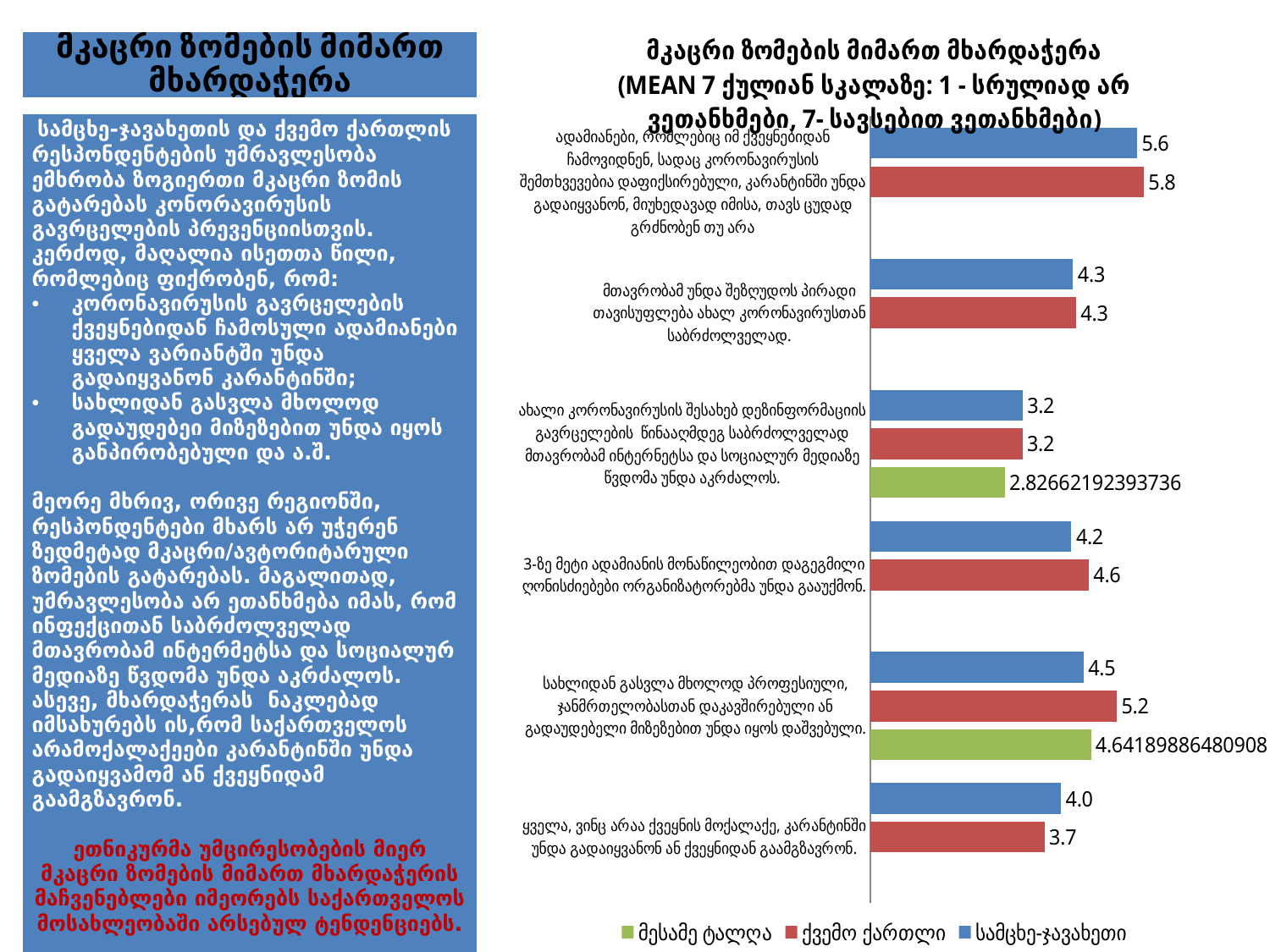
What is the difference between ქვემო ქართლი and სამცხე-ჯავახეთი on the statement about leaving home only for professional, health-related or urgent reasons? 0.7 How many categories (statements) are plotted on the chart? 6 How many series does the chart legend list? 3 Which is larger on the top category (quarantining people arriving from countries with confirmed cases): the value for ქვემო ქართლი or for სამცხე-ჯავახეთი? ქვემო ქართლი What is the value for ქვემო ქართლი on the statement about people arriving from countries where coronavirus cases are confirmed being quarantined (the top category)? 5.8 Which series has the highest value on the statement that everyone who is not a citizen should be quarantined or expelled (the bottom category)? სამცხე-ჯავახეთი Which colour represents the series ქვემო ქართლი in the chart? red What is the value for სამცხე-ჯავახეთი on the statement that the government should limit personal freedom to fight the new coronavirus? 4.3 What is the value for მესამე ტალღა on the statement that the government should control the internet and social media against disinformation? 2.82662192393736 What is the value for ქვემო ქართლი on the statement that gatherings of more than 3 people should be banned by law enforcement? 4.6 What is the value for მესამე ტალღა on the statement that leaving home should be allowed only for professional, health-related or urgent reasons? 4.64189886480908 What kind of chart is shown on the slide? bar chart